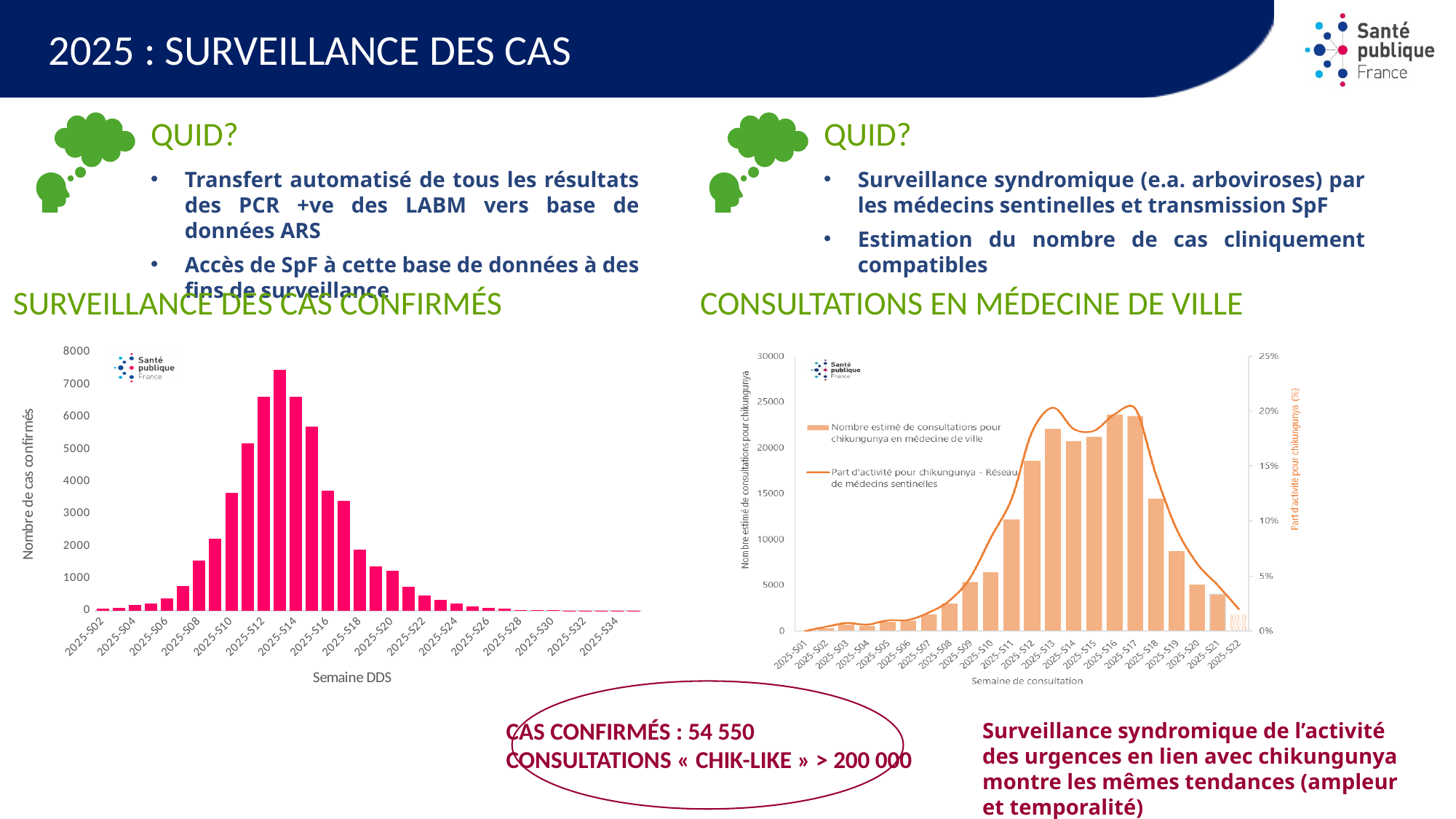
On the left chart, what is the label of the x axis? Semaine DDS On the left chart, do the values rise or fall from 2025-S16 to 2025-S26? fall On the right chart, is the number of estimated consultations for 2025-S19 greater or less than 10000? less On the left chart, is the value for 2025-S10 greater or less than 3000? greater On the left chart, is the value for 2025-S20 greater or less than 2000? less On the left chart, what is the label of the y axis? Nombre de cas confirmés What kind of chart is the 'Surveillance des cas confirmés' chart on the left? bar chart On the 'Consultations en médecine de ville' chart on the right, how many series does the legend list? 2 On the right chart, which is larger: the number of estimated consultations for 2025-S12 or for 2025-S20? 2025-S12 On the right chart, how many weeks are shown on the x axis? 22